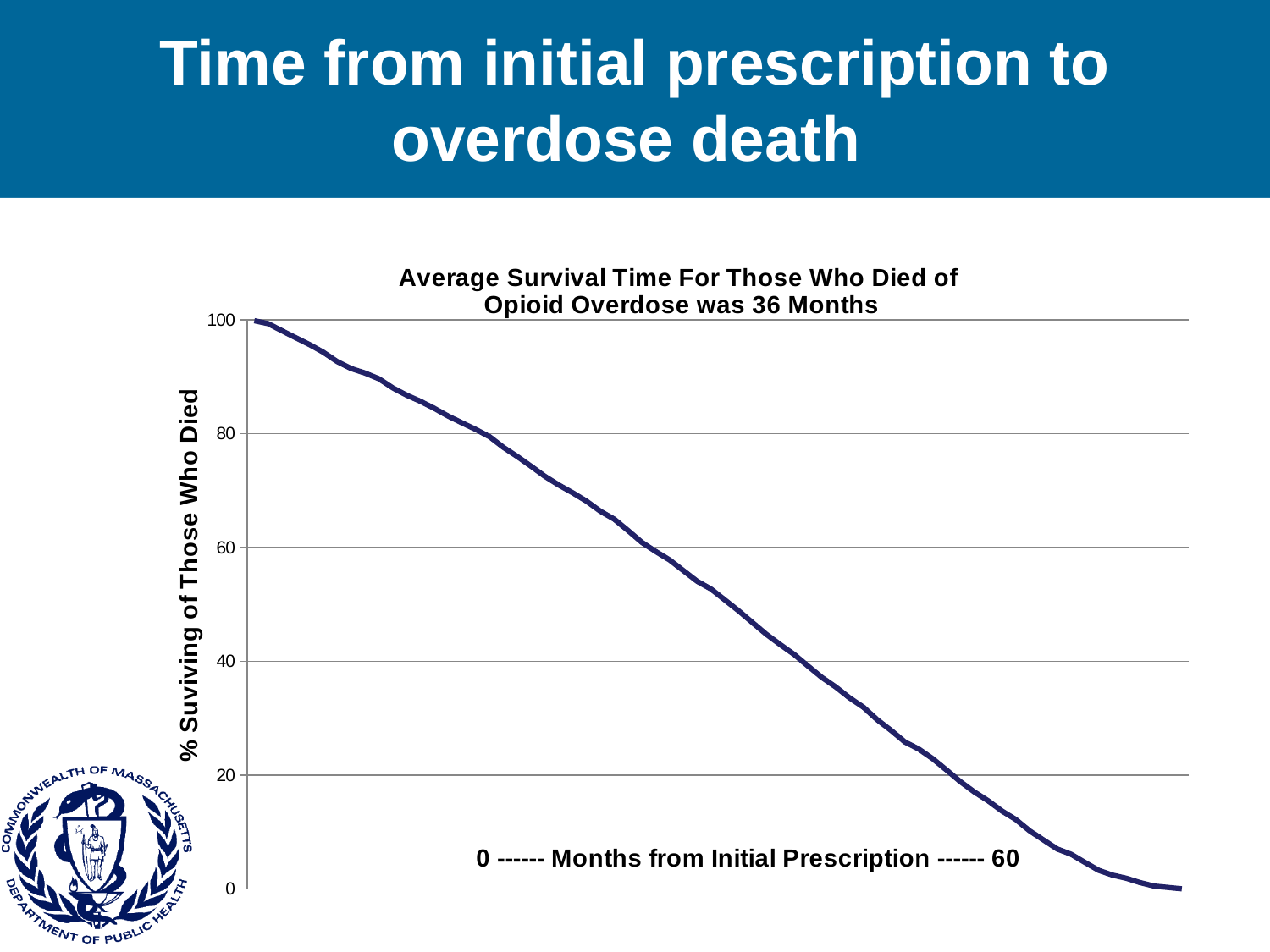
Is the percentage surviving at the midpoint of the x axis greater or less than 80? less At which end of the x axis is the percentage surviving highest? 0 months (the start) Is the percentage surviving higher at the start of the line or at the end of the line? at the start At which end of the x axis is the percentage surviving lowest? 60 months (the end) Does the percentage surviving rise or fall as months from initial prescription increase? fall What is the label on the y axis of the chart? % Surviving of Those Who Died What is the title of the chart? Average Survival Time For Those Who Died of Opioid Overdose was 36 Months Is the percentage surviving at the midpoint of the x axis greater or less than 20? greater What kind of chart is shown on the slide? line chart